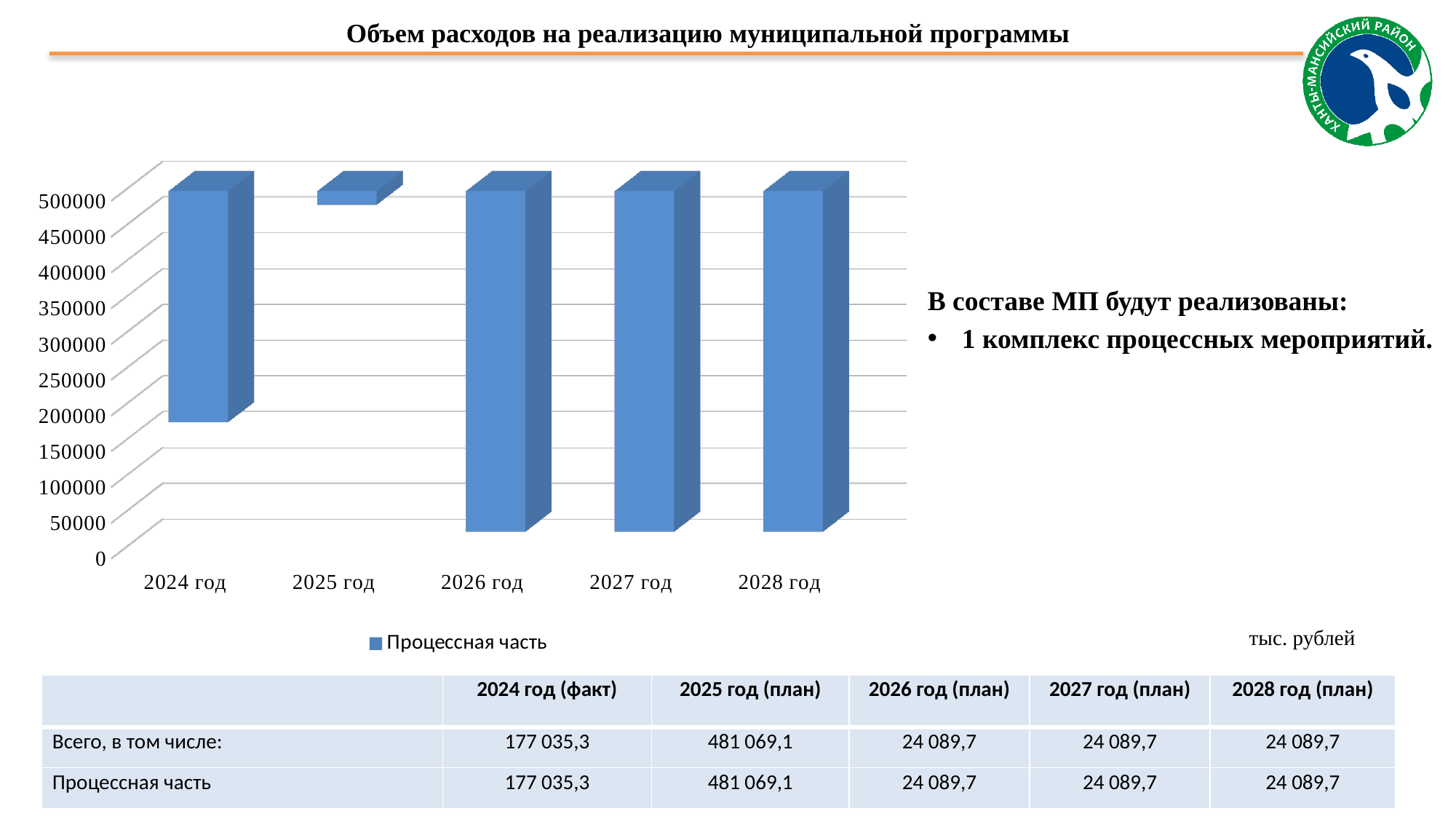
What is the value for 2027 год in the chart? 24 089,7 What kind of chart is shown on the slide? Bar chart How many years are shown on the x axis of the chart? 5 What is the value for 2025 год in the chart? 481 069,1 Which year has the highest value in the chart? 2025 год What is the difference between the values for 2024 год and 2028 год? 152 945,6 What is the value for 2024 год in the chart? 177 035,3 Which is larger, the value for 2024 год or the value for 2026 год? 2024 год What is the difference between the values for 2025 год and 2024 год? 304 033,8 Which is larger, the value for 2024 год or the value for 2025 год? 2025 год What is the name of the series shown in the chart legend? Процессная часть How many series does the chart legend list? 1